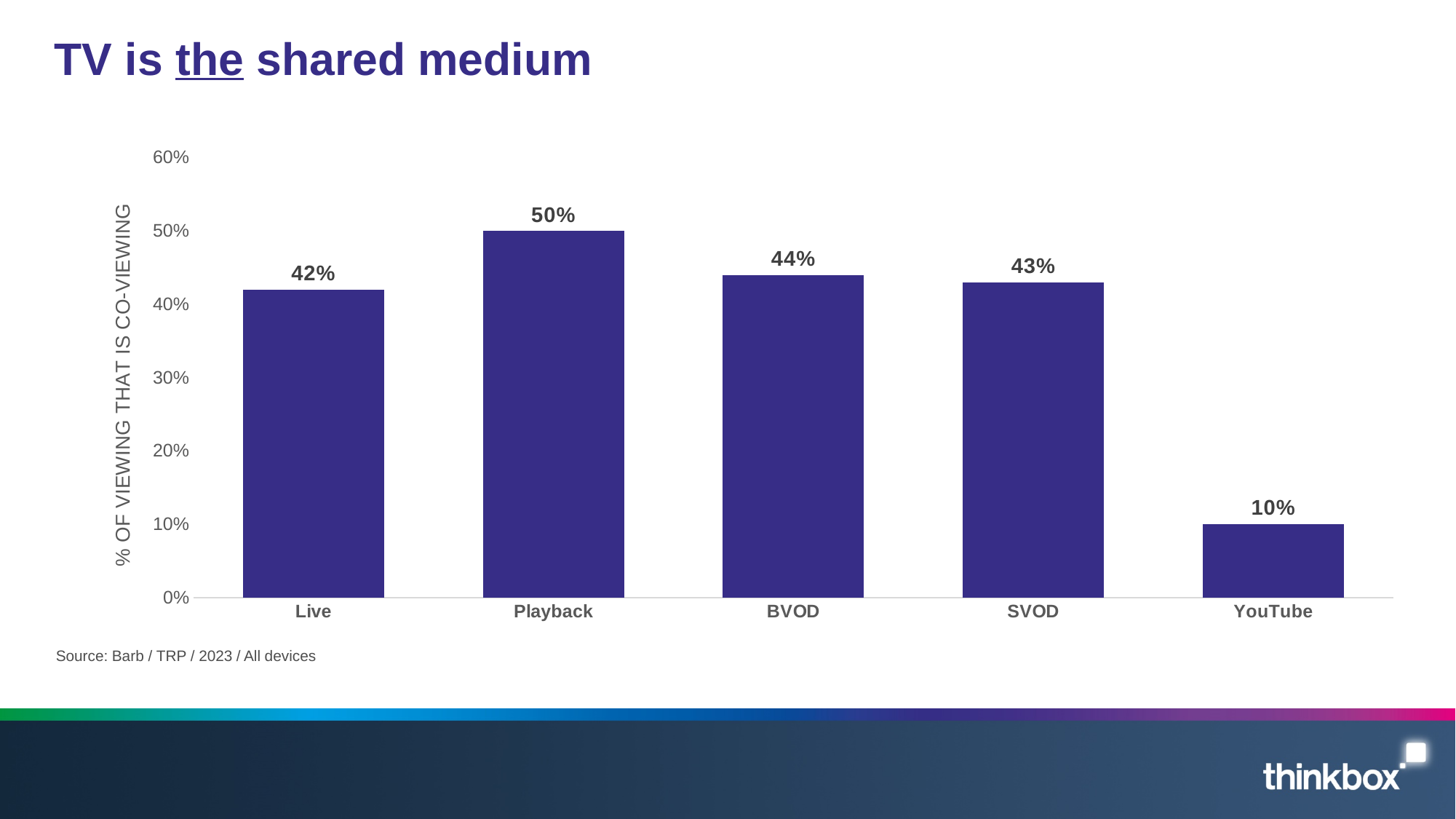
How many categories are shown on the x axis? 5 What is the value for SVOD? 43% What is the value for YouTube? 10% Which category has the highest value? Playback What kind of chart is shown on the slide? Bar chart What is the difference between the values for Playback and YouTube? 40% What is the value for Playback? 50% Which is larger, the value for Playback or the value for Live? Playback What is the value for Live? 42% Which category has the lowest value? YouTube What is the label of the vertical axis? % OF VIEWING THAT IS CO-VIEWING What is the difference between the values for BVOD and Live? 2%